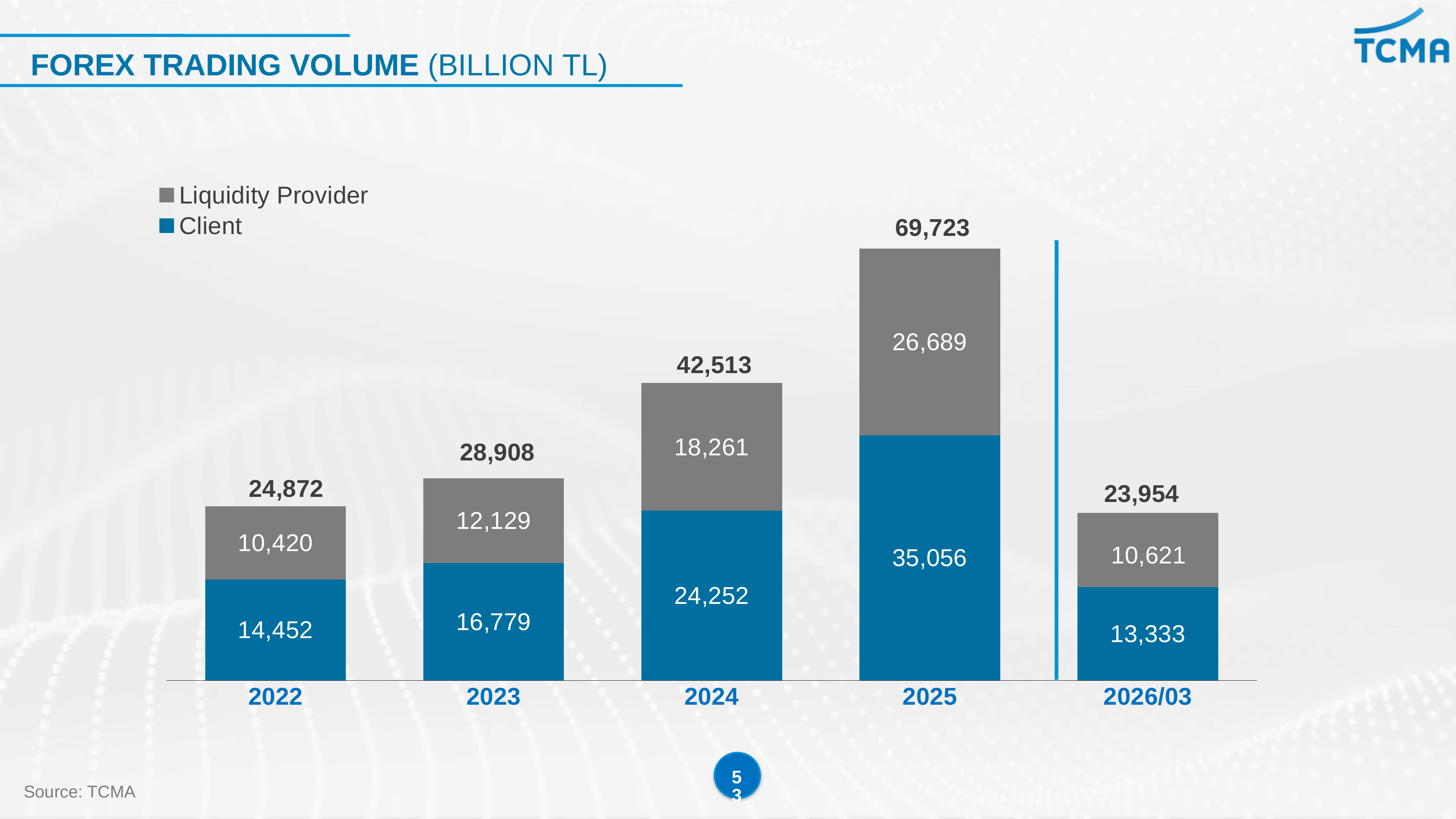
How many series does the legend list? 2 Which year has the highest total forex trading volume? 2025 Do the total values rise or fall from 2022 to 2025? Rise How many categories are shown on the x axis? 5 Which is larger, the Liquidity Provider value for 2022 or the Liquidity Provider value for 2026/03? 2026/03 What is the total forex trading volume shown for 2025? 69,723 Which category has the lowest total forex trading volume? 2026/03 What is the Liquidity Provider value for 2023? 12,129 What is the Liquidity Provider value for 2026/03? 10,621 What is the difference between the Client value in 2025 and the Client value in 2024? 10,804 What kind of chart is shown on the slide? Stacked bar chart What is the Client value for 2024? 24,252